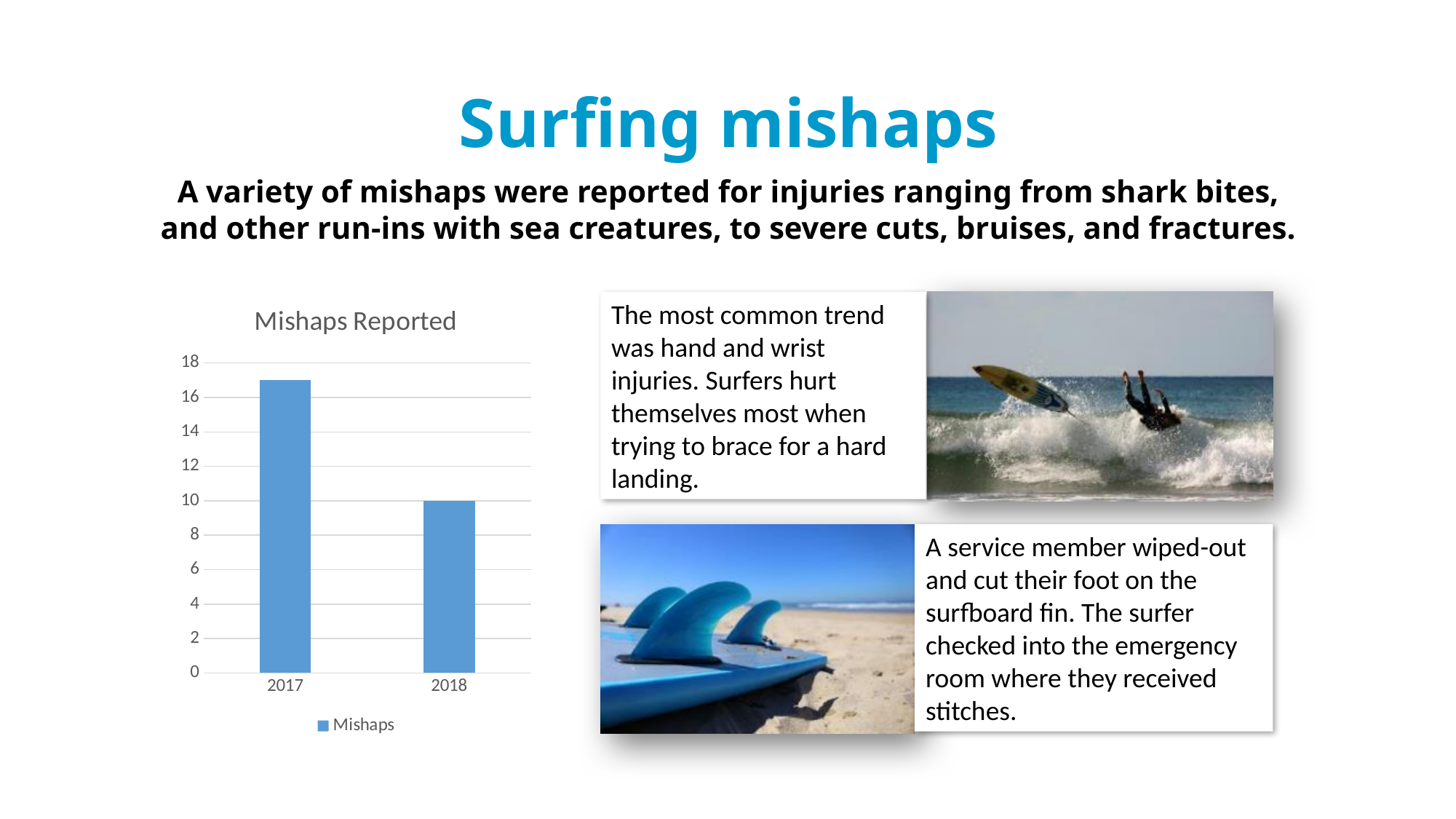
How many years are plotted in the Mishaps Reported chart? 2 Do the mishaps reported rise or fall from 2017 to 2018? fall Which year has the highest number of mishaps reported? 2017 Is the value for 2017 in the Mishaps Reported chart greater or less than 16? greater What kind of chart is shown on the slide? bar chart What is the title of the chart? Mishaps Reported What is the name of the series shown in the chart legend? Mishaps Which year has the lowest number of mishaps reported? 2018 Which year has more mishaps reported, 2017 or 2018? 2017 How many series does the legend of the Mishaps Reported chart list? 1 Is the value for 2017 in the Mishaps Reported chart greater or less than 18? less What is the value for 2018 in the Mishaps Reported chart? 10